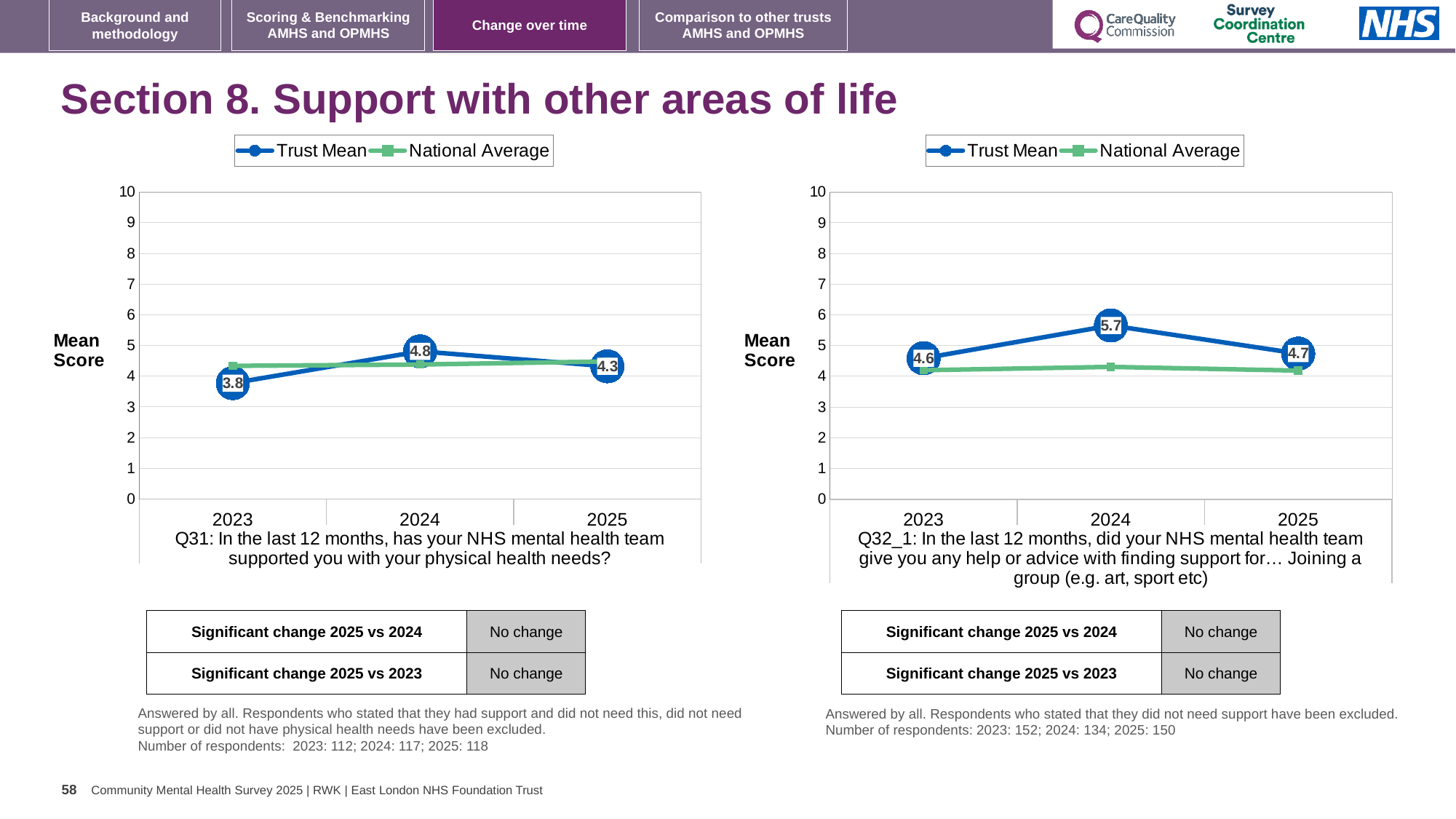
On the left chart (Q31), what is the Trust Mean for 2023? 3.8 How many series does the legend of the left chart (Q31) list? 2 On the left chart (Q31), what is the Trust Mean for 2024? 4.8 On the right chart (Q32_1), is the Trust Mean for 2024 greater or less than the Trust Mean for 2023? greater On the left chart (Q31), which year has the highest Trust Mean? 2024 On the right chart (Q32_1), which year has the lowest Trust Mean? 2023 On the right chart (Q32_1), is the National Average for 2024 greater or less than 5? less What kind of chart is the right chart (Q32_1)? Line chart On the right chart (Q32_1), what is the Trust Mean for 2024? 5.7 On the left chart (Q31), what is the difference between the Trust Mean for 2024 and 2023? 1.0 On the right chart (Q32_1), what is the difference between the Trust Mean for 2024 and 2025? 1.0 On the right chart (Q32_1), what is the Trust Mean for 2025? 4.7